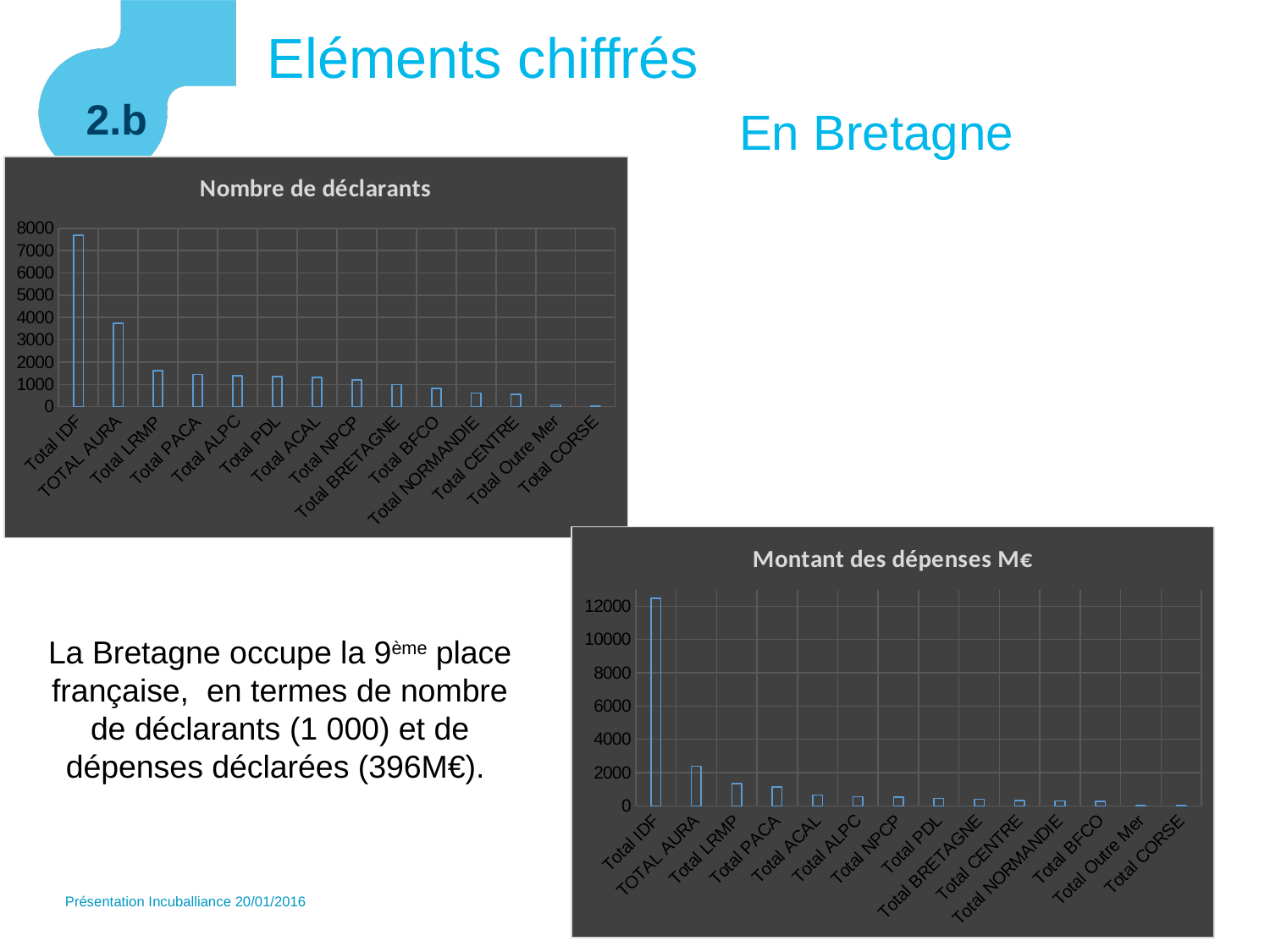
In the 'Nombre de déclarants' chart, is the value for TOTAL AURA greater or less than 3000? greater How many categories are shown in the 'Nombre de déclarants' chart? 14 How many categories are shown in the 'Montant des dépenses M€' chart? 14 In the 'Nombre de déclarants' chart, which category has the lowest value? Total CORSE In the 'Nombre de déclarants' chart, which is larger, TOTAL AURA or Total LRMP? TOTAL AURA In the 'Montant des dépenses M€' chart, is the value for Total IDF greater or less than 12000? greater In the 'Montant des dépenses M€' chart, is the value for Total LRMP greater or less than 2000? less What type of chart is the 'Nombre de déclarants' chart? bar chart In the 'Nombre de déclarants' chart, which category has the highest value? Total IDF In the 'Nombre de déclarants' chart, do the values rise or fall from left to right along the x axis? fall In the 'Montant des dépenses M€' chart, which category has the highest value? Total IDF